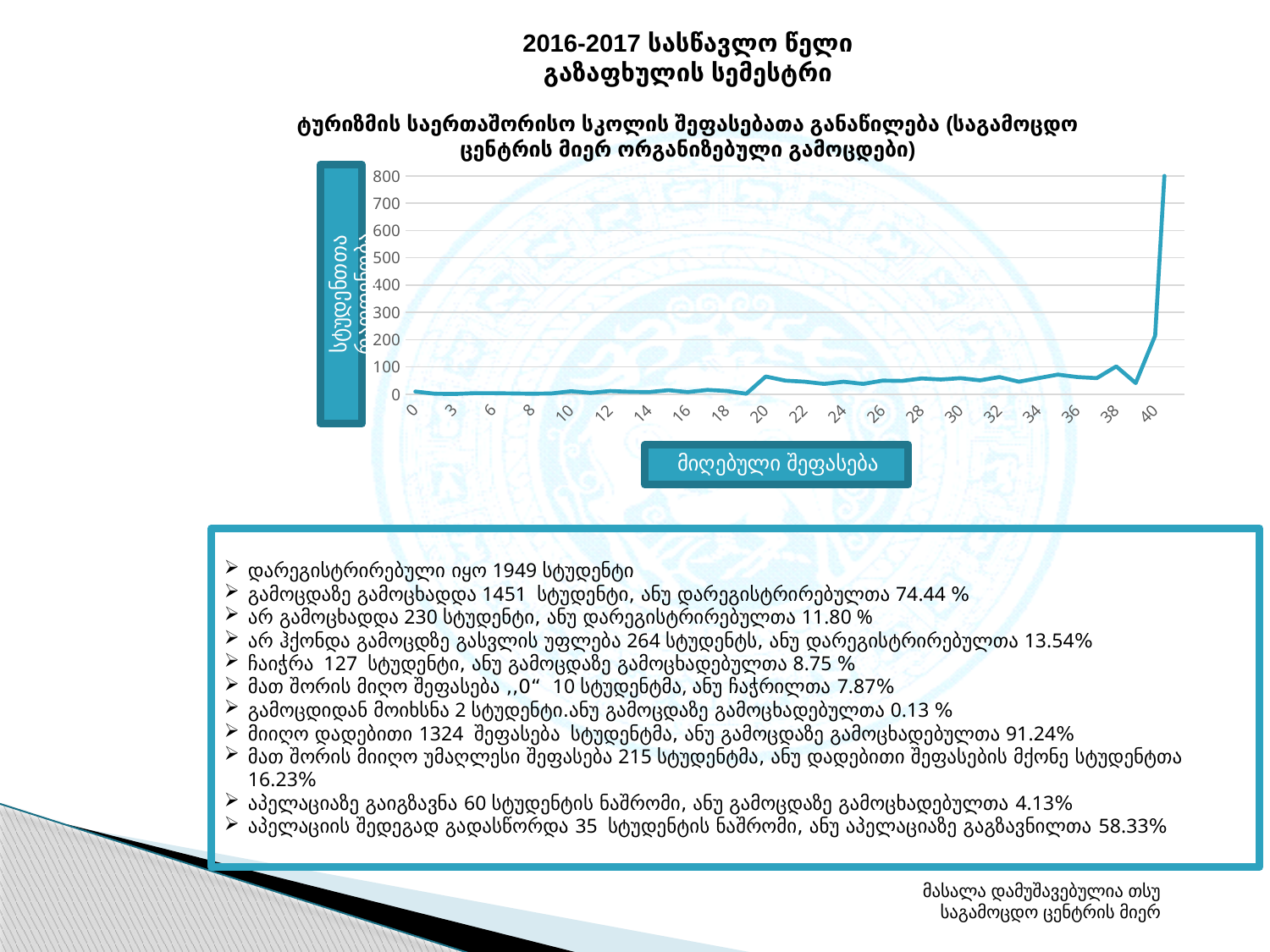
What kind of chart is shown on the slide? line chart Is the value at x = 20 greater or less than 100? less Does the line rise or fall sharply at the right end of the x axis? rises Is the value at x = 30 greater or less than 100? less Is the value at x = 38 greater or less than 200? less Is the highest value of the line at the left end or the right end of the x axis? right end What is the title of the y axis of the chart? სტუდენტთა რაოდენობა What is the title of the x axis of the chart? მიღებული შეფასება What is the highest tick value shown on the y axis? 800 Which is larger, the value at x = 20 or the value at x = 10? x = 20